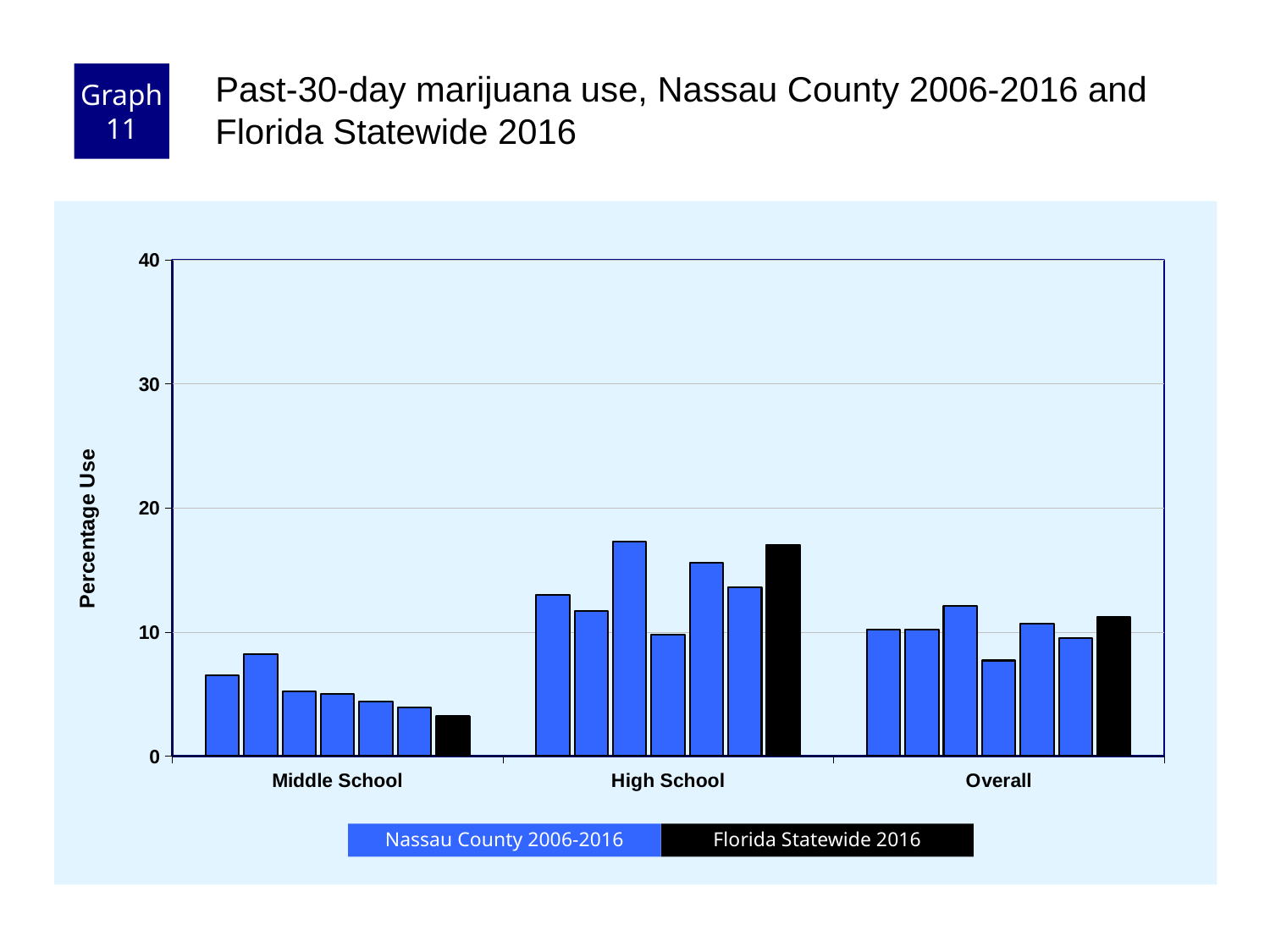
Which series is shown in black? Florida Statewide 2016 What kind of chart is shown on the slide? bar chart Which category has the lowest Florida Statewide 2016 value? Middle School How many categories are shown on the x axis? 3 Is the Florida Statewide 2016 value for Middle School greater or less than 10? less Is the Florida Statewide 2016 value for High School greater or less than 20? less Is the Florida Statewide 2016 value for High School greater or less than 10? greater How many series does the legend list? 2 Which is larger, the Florida Statewide 2016 value for High School or for Middle School? High School Which category has the highest Florida Statewide 2016 value? High School What is the label of the y axis? Percentage Use